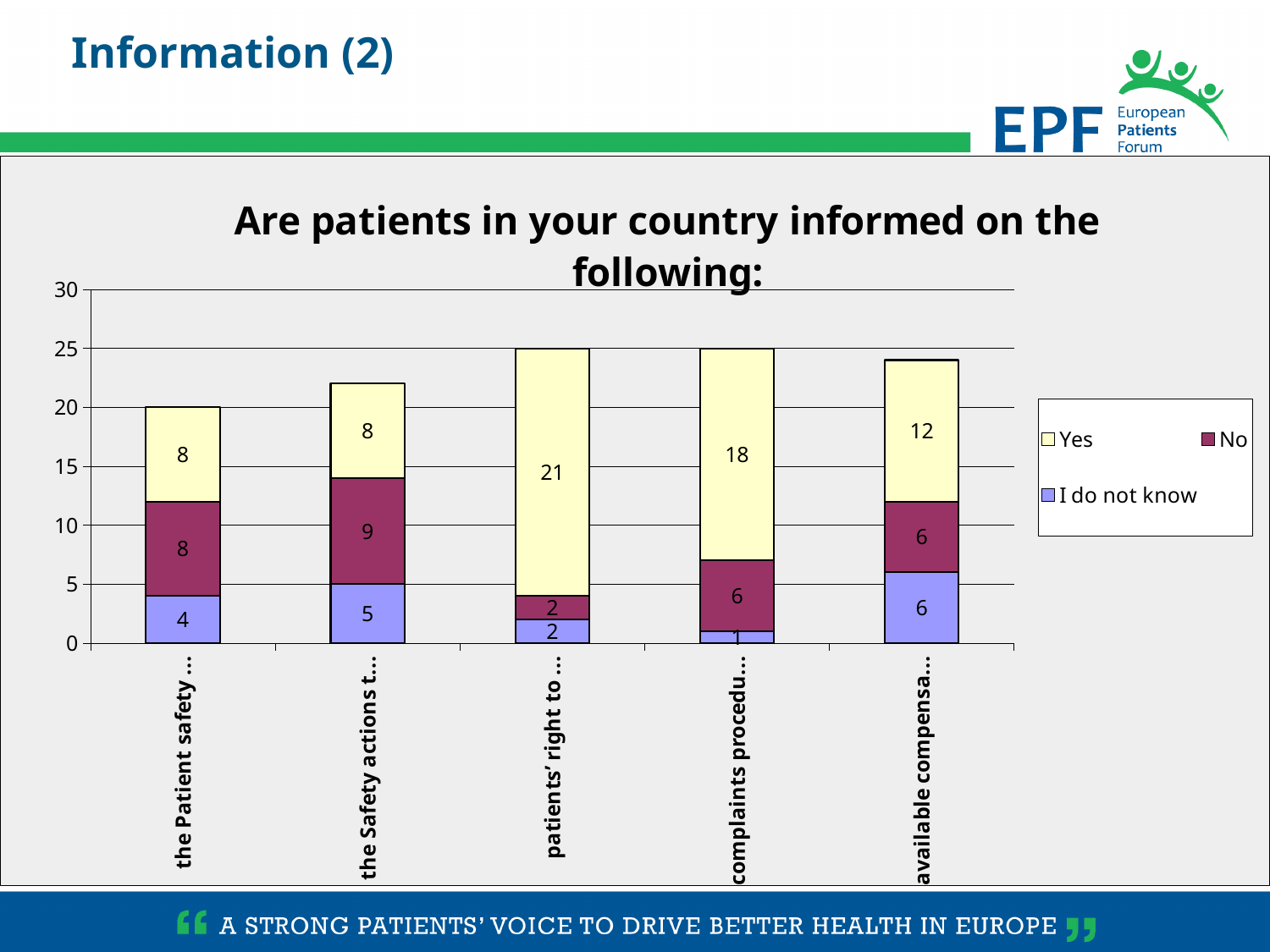
Which category has the highest 'Yes' value? patients' right to ... How many series does the legend list? 3 What is the 'No' value for the category 'the Safety actions t...'? 9 What type of chart is shown on the slide? stacked bar chart Which legend entry is shown in yellow? Yes How many categories are shown on the x axis? 5 Which category has the lowest 'I do not know' value? complaints procedu... What is the 'Yes' value for the category 'patients' right to ...'? 21 What is the difference between the 'Yes' values for 'complaints procedu...' and 'available compensa...'? 6 Which is larger: the 'No' value for 'the Patient safety ...' or the 'No' value for 'available compensa...'? the Patient safety ... What is the 'I do not know' value for the category 'available compensa...'? 6 What is the total of the stacked bar for 'the Safety actions t...'? 22